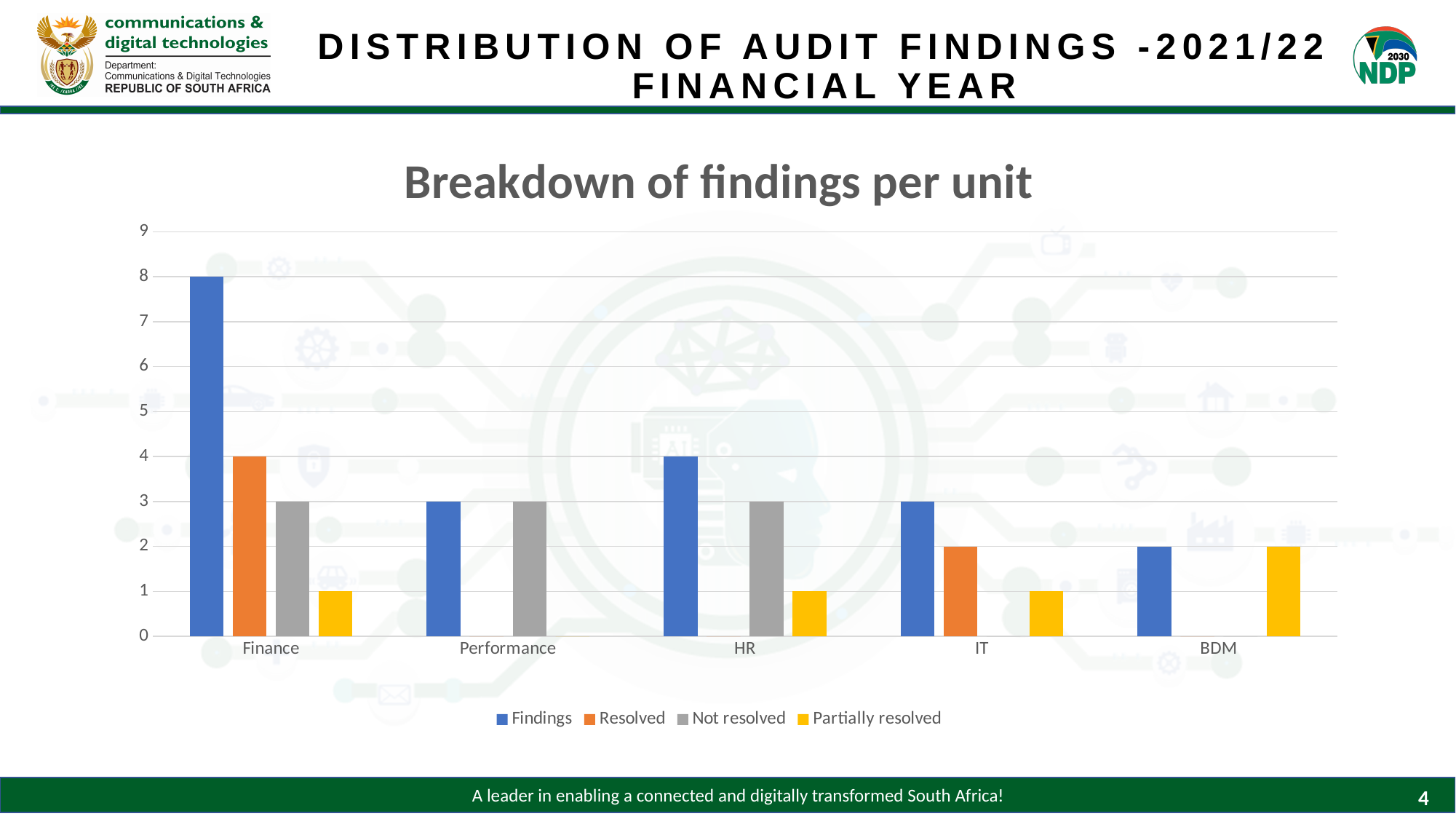
How many units are shown on the x axis? 5 What is the value of Resolved for IT? 2 What is the difference between Findings and Resolved for Finance? 4 What is the value of Partially resolved for BDM? 2 Which unit has the highest number of Findings? Finance What is the title of the chart? Breakdown of findings per unit What kind of chart is shown on the slide? Bar chart Which is larger, Findings for HR or Findings for IT? Findings for HR What is the value of Not resolved for HR? 3 What is the value of Findings for Finance? 8 How many series does the legend list? 4 Which unit has the lowest number of Findings? BDM